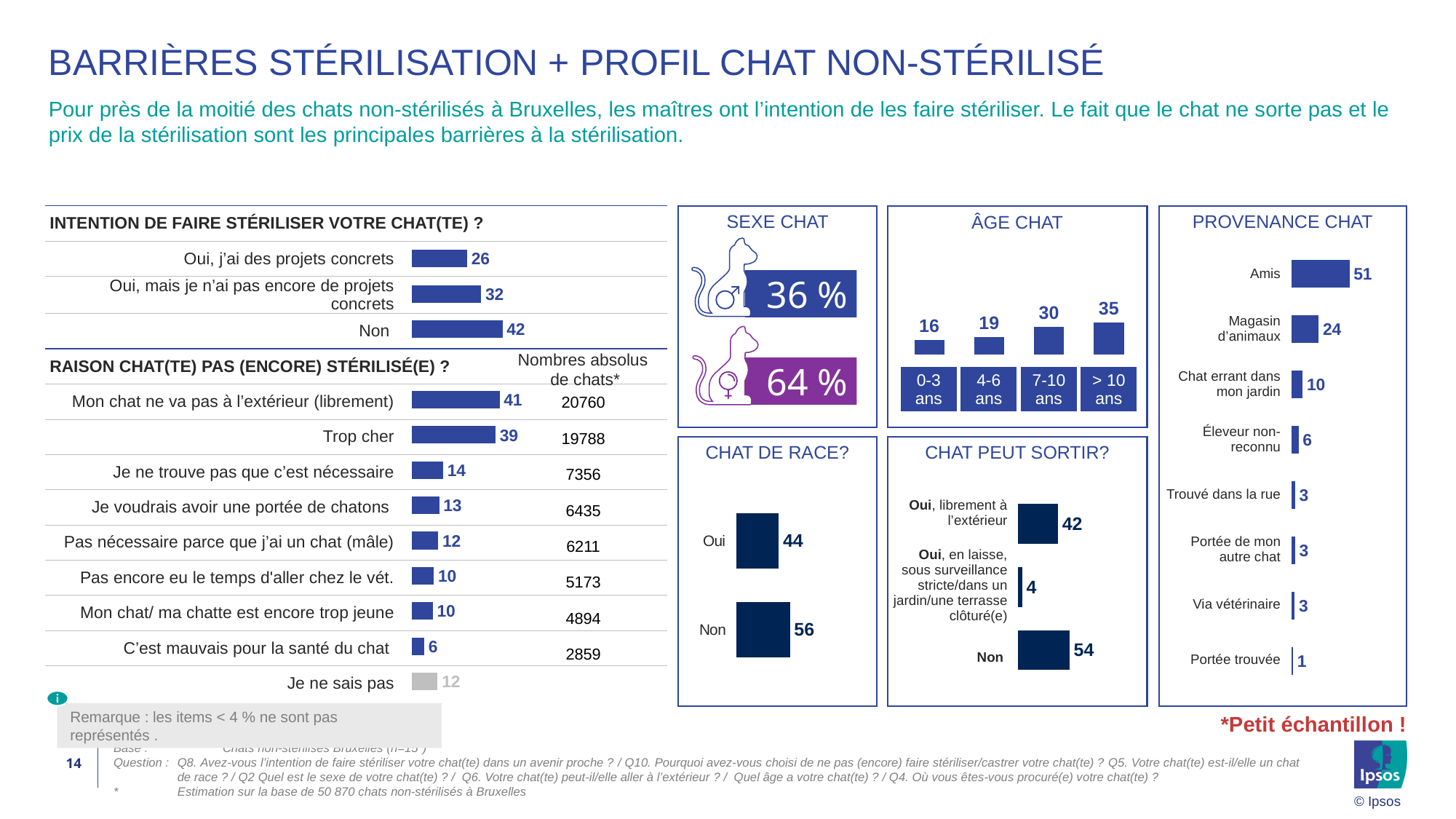
In the "INTENTION DE FAIRE STÉRILISER VOTRE CHAT(TE) ?" chart, what is the difference between "Non" and "Oui, j'ai des projets concrets"? 16 In the "PROVENANCE CHAT" chart, what is the value for "Magasin d'animaux"? 24 In the "CHAT DE RACE?" chart, which is larger, "Oui" or "Non"? Non In the "CHAT PEUT SORTIR?" chart, what is the value for "Non"? 54 In the "PROVENANCE CHAT" chart, which category has the lowest value? Portée trouvée In the "INTENTION DE FAIRE STÉRILISER VOTRE CHAT(TE) ?" chart, what is the value for "Non"? 42 In the "RAISON CHAT(TE) PAS (ENCORE) STÉRILISÉ(E) ?" chart, what absolute number of cats is shown for "Je ne trouve pas que c'est nécessaire"? 7356 In the "RAISON CHAT(TE) PAS (ENCORE) STÉRILISÉ(E) ?" chart, what is the value for "Trop cher"? 39 In the "ÂGE CHAT" chart, do the values rise or fall from "0-3 ans" to "> 10 ans"? rise In the "RAISON CHAT(TE) PAS (ENCORE) STÉRILISÉ(E) ?" chart, which reason has the highest value? Mon chat ne va pas à l'extérieur (librement) In the "SEXE CHAT" chart, what percentage is shown for female cats? 64 % In the "ÂGE CHAT" chart, how many age categories are shown? 4